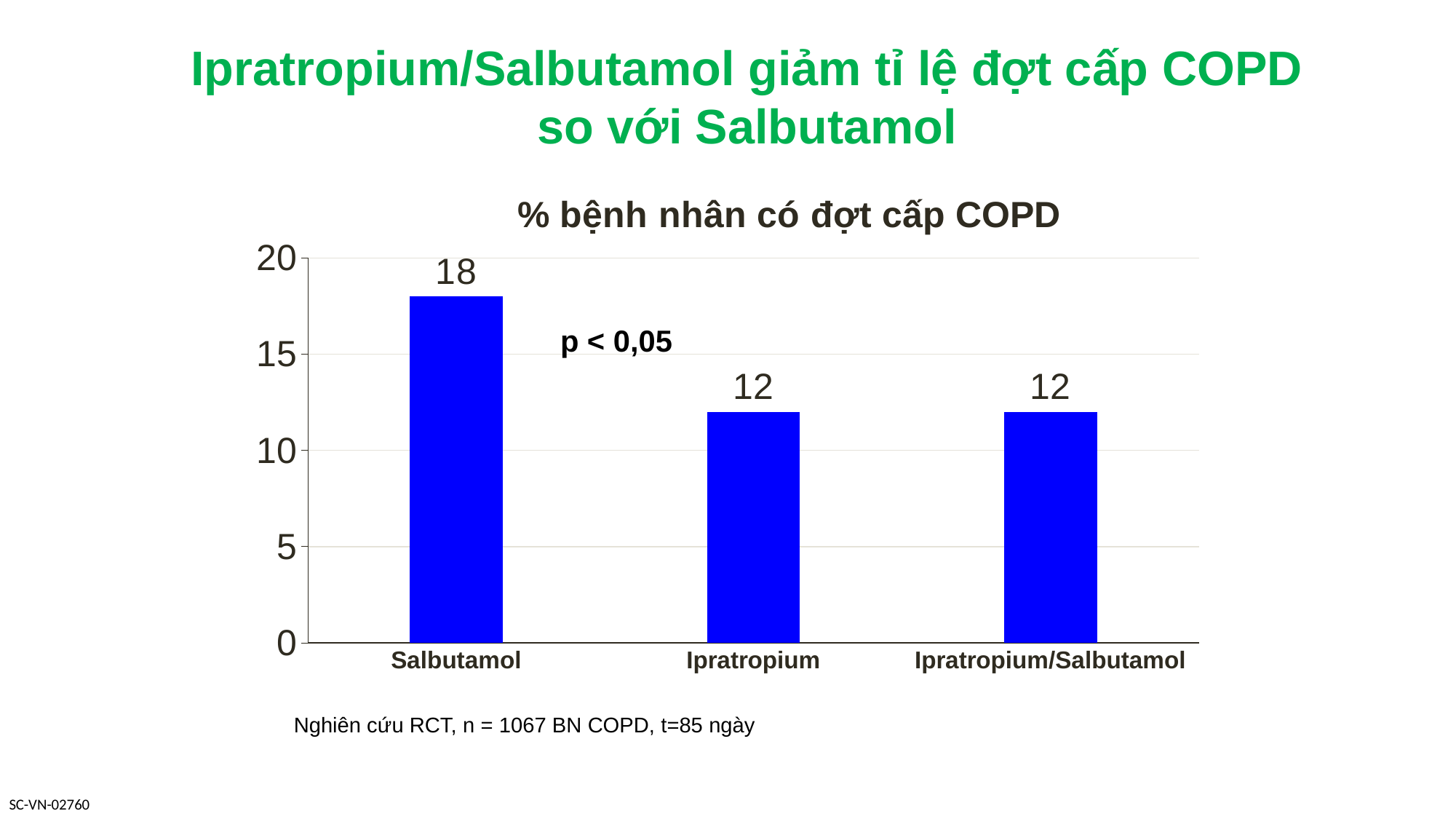
Is the value for Ipratropium greater or less than 15? less Which category has the highest value? Salbutamol What is the value for Ipratropium? 12 What is the title of the chart? % bệnh nhân có đợt cấp COPD How many categories are shown on the x axis? 3 What is the value for Salbutamol? 18 Which is larger, the value for Salbutamol or the value for Ipratropium/Salbutamol? Salbutamol What kind of chart is shown on the slide? bar chart What is the value for Ipratropium/Salbutamol? 12 What is the difference between the values for Salbutamol and Ipratropium? 6 Is the value for Salbutamol greater or less than 15? greater What p-value is annotated on the chart? p < 0,05